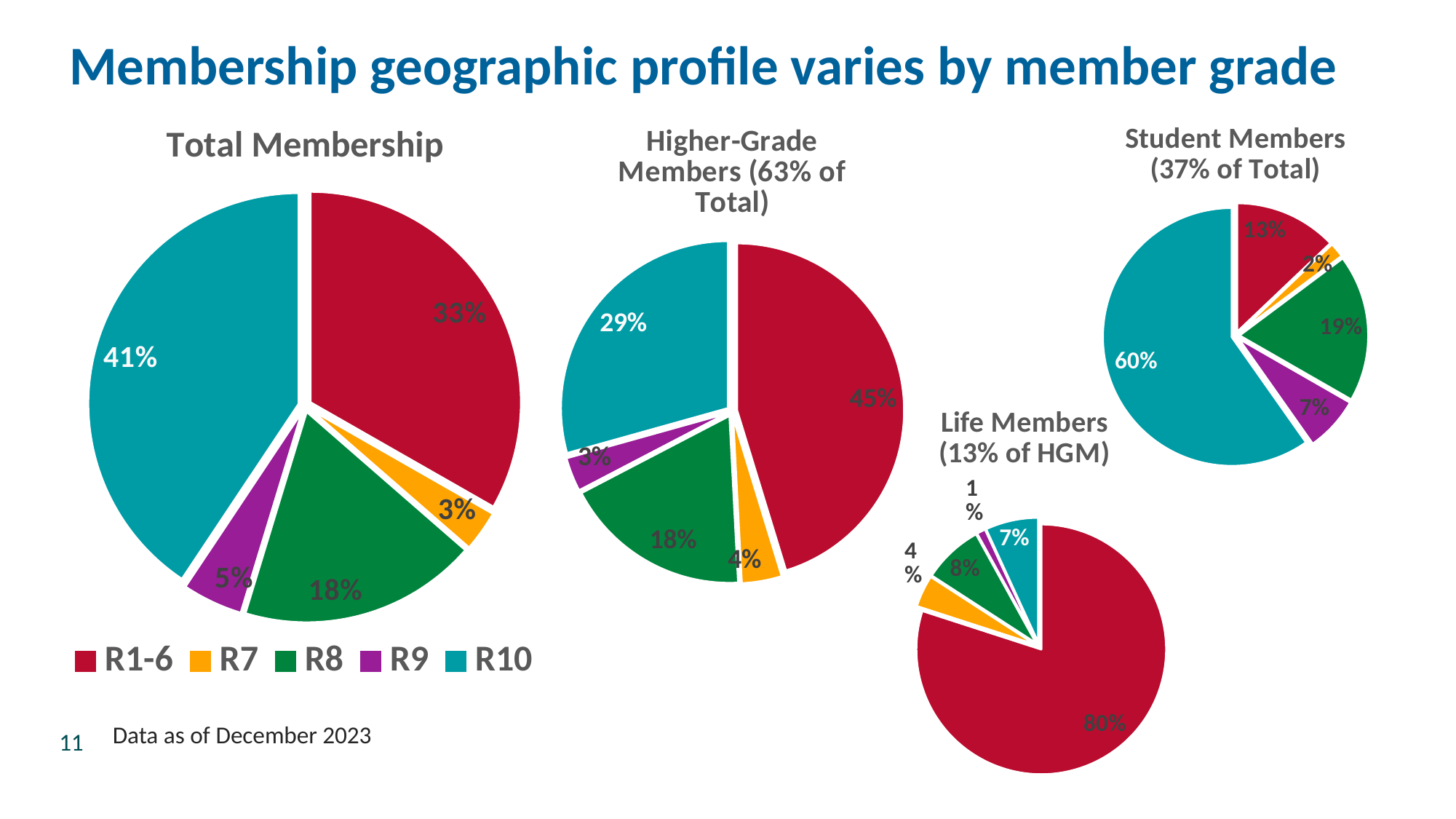
In the Student Members pie chart, what is the value for R8? 19% How many series does the legend list? 5 In the Higher-Grade Members pie chart, which region has the smallest share? R9 In the Higher-Grade Members pie chart, what is the value for R1-6? 45% In the Total Membership pie chart, what share does R10 have? 41% In the Life Members pie chart, what is the difference between the R1-6 share and the R8 share? 72% In the Total Membership pie chart, what is the value for R1-6? 33% In the Student Members pie chart, which region has the largest share? R10 In the Life Members pie chart, what is the value for R1-6? 80% In the Total Membership pie chart, which is larger, the share for R8 or the share for R9? R8 How many pie charts are shown on the slide? 4 What kind of chart is the Total Membership chart? Pie chart